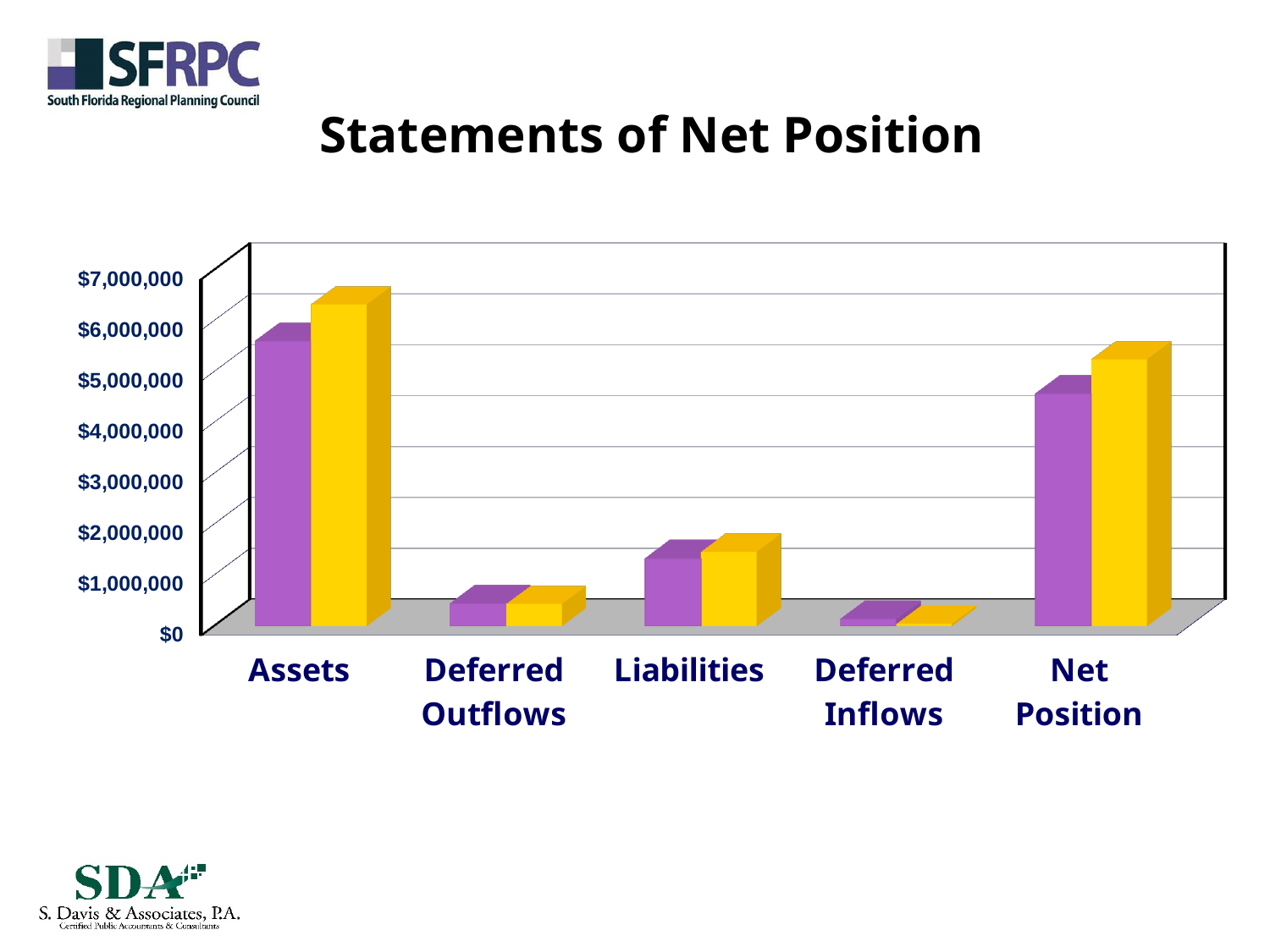
Is the value of the yellow Deferred Outflows bar greater or less than $1,000,000? less What kind of chart is shown on the slide? bar chart Is the value of the purple Assets bar greater or less than $5,000,000? greater For Assets, which bar is taller, the purple bar or the yellow bar? the yellow bar Which category has the tallest bars in the chart? Assets What is the title of the chart? Statements of Net Position Which category has the shortest bars in the chart? Deferred Inflows Is the value of the purple Net Position bar greater or less than $4,000,000? greater What two colours are used for the bars in the chart? purple and yellow How many categories are shown on the x axis of the chart? 5 How many bars are plotted for each category in the chart? 2